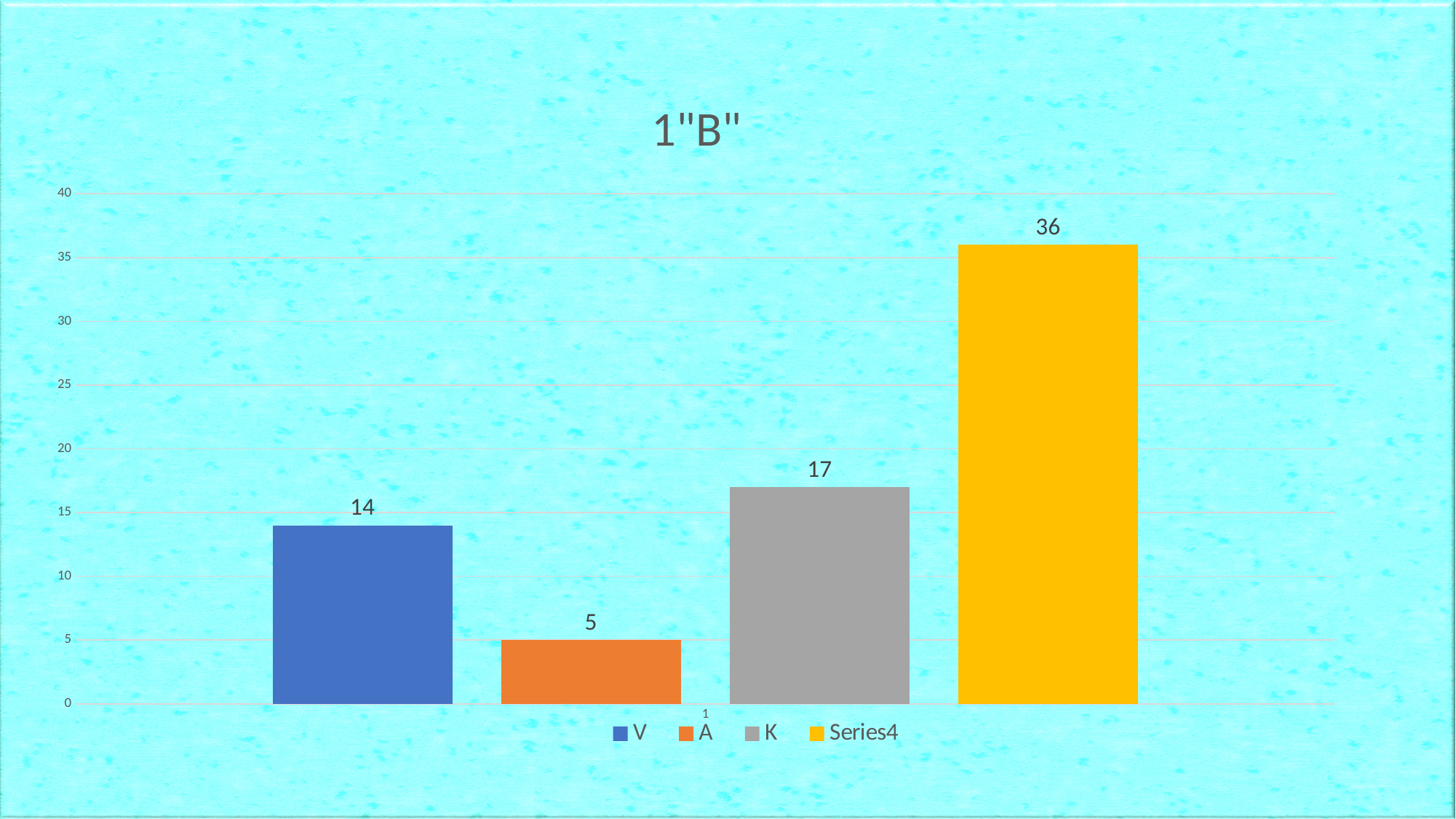
Which is larger, the value for K or the value for V? K Which series has the lowest value? A What is the title of the chart? 1"B" What is the value of the A series? 5 What is the value of the V series? 14 What is the value of the K series? 17 What is the difference between the values of Series4 and K? 19 What is the value of Series4? 36 How many series does the legend list? 4 Which series has the highest value? Series4 What is the difference between the values of V and A? 9 What kind of chart is shown on the slide? Bar chart